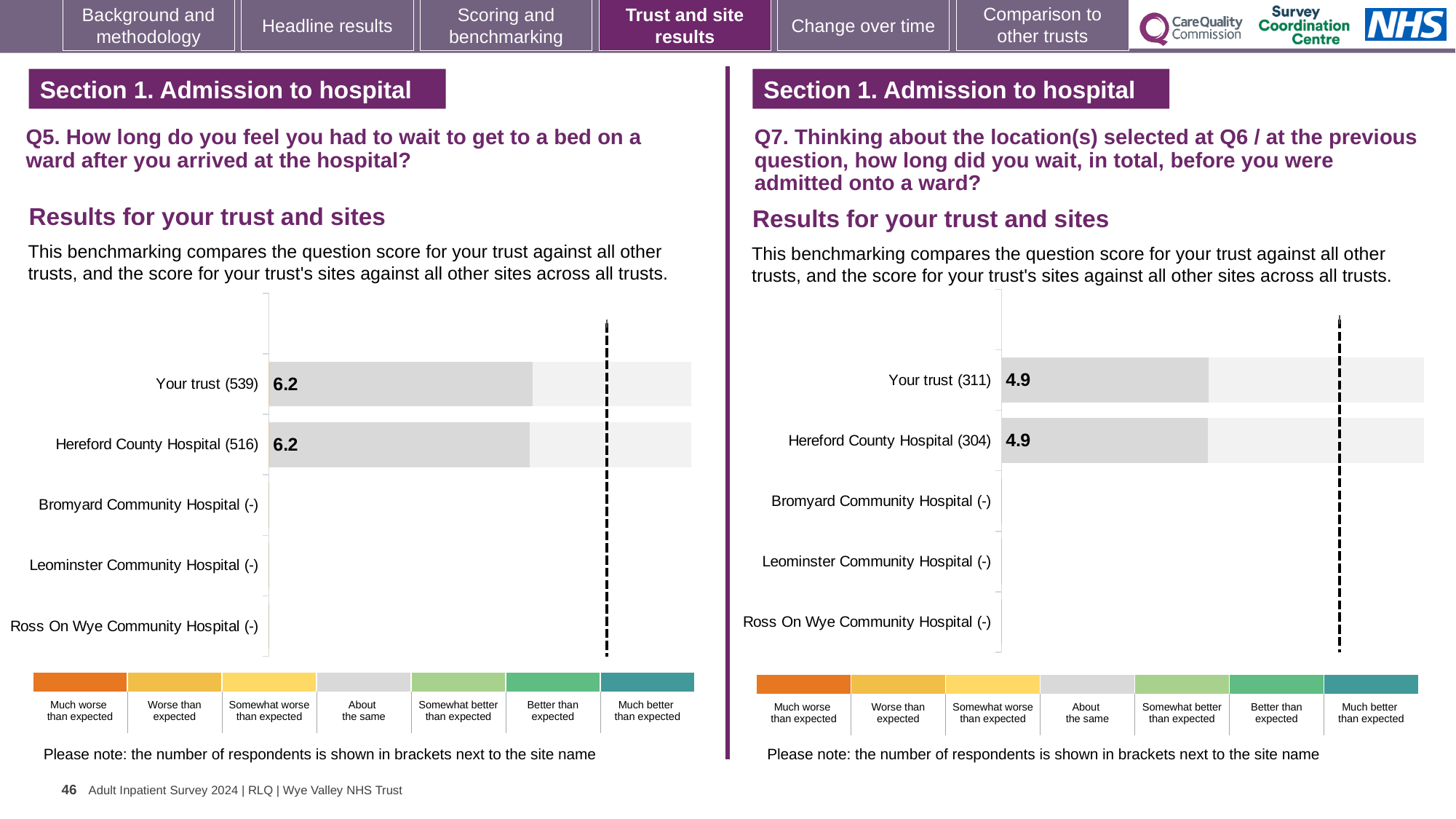
How many site categories are listed on the left chart (Q5)? 5 How many categories does the colour legend below each chart list? 7 On the left chart (Q5), what is the difference between the score for Your trust and the score for Hereford County Hospital? 0 What kind of chart is used on the left (Q5)? Bar chart On the left chart (Q5), what is the score for Your trust? 6.2 Is the score for Your trust on the left chart (Q5) larger or smaller than the score for Your trust on the right chart (Q7)? larger On the right chart (Q7), what is the score for Your trust? 4.9 On the left chart (Q5), what is the score for Hereford County Hospital? 6.2 How many site categories are listed on the right chart (Q7)? 5 On the left chart (Q5), how many respondents are shown in brackets for Hereford County Hospital? 516 On the right chart (Q7), how many respondents are shown in brackets for Your trust? 311 On the right chart (Q7), what is the score for Hereford County Hospital? 4.9